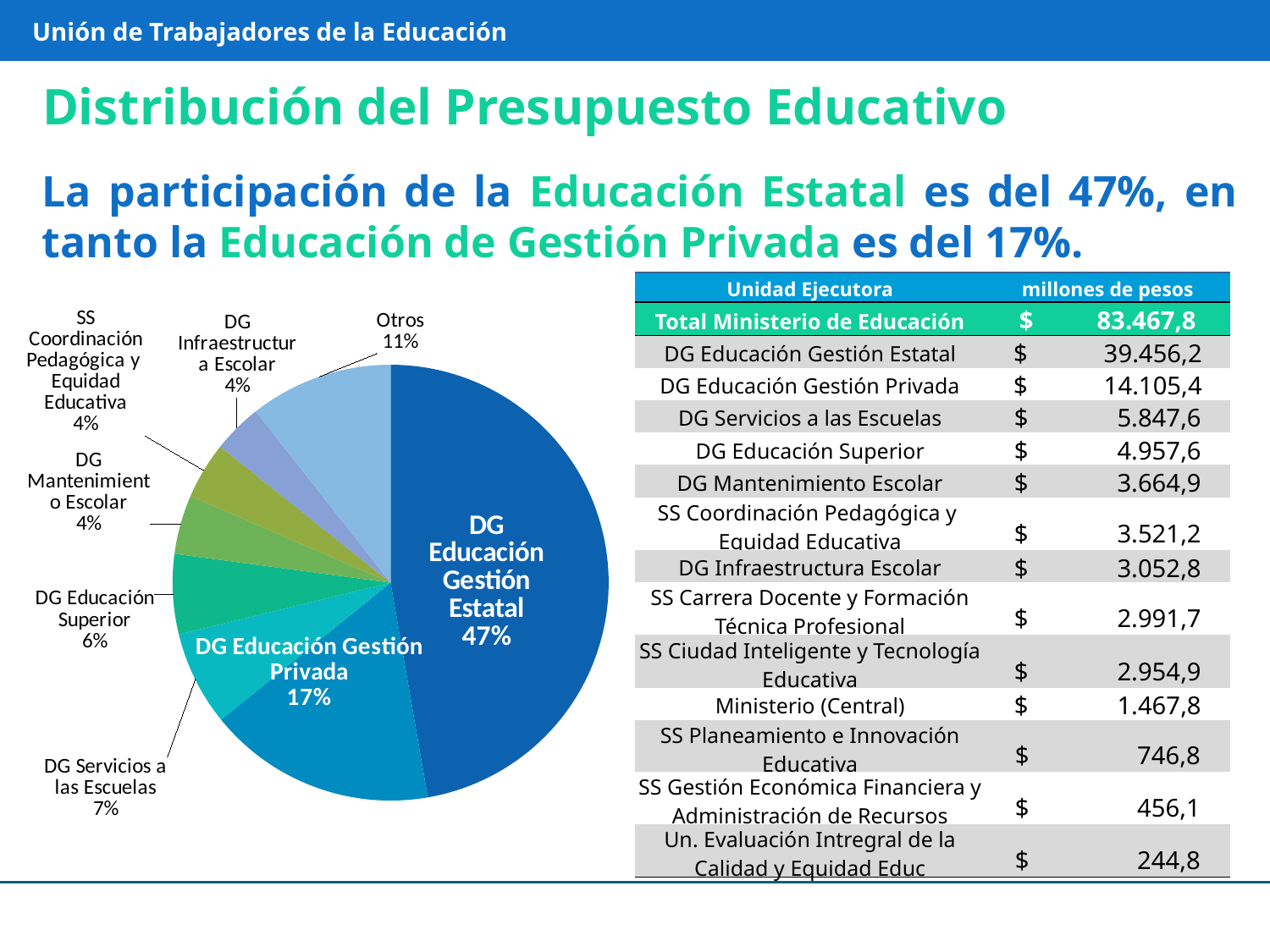
What kind of chart is shown on the slide? pie chart What share of the pie does DG Educación Gestión Estatal represent? 47% What percentage is shown for DG Mantenimiento Escolar in the pie chart? 4% What percentage is shown for DG Educación Superior in the pie chart? 6% What percentage is shown for DG Servicios a las Escuelas in the pie chart? 7% What percentage is shown for Otros in the pie chart? 11% Which is larger in the pie chart, Otros or DG Servicios a las Escuelas? Otros Which two slices of the pie chart have their labels printed inside the slices? DG Educación Gestión Estatal and DG Educación Gestión Privada How many slices does the pie chart have? 8 What is the difference in percentage points between DG Educación Gestión Estatal and DG Educación Gestión Privada in the pie chart? 30 percentage points Which slice of the pie chart is the largest? DG Educación Gestión Estatal What share of the pie does DG Educación Gestión Privada represent? 17%